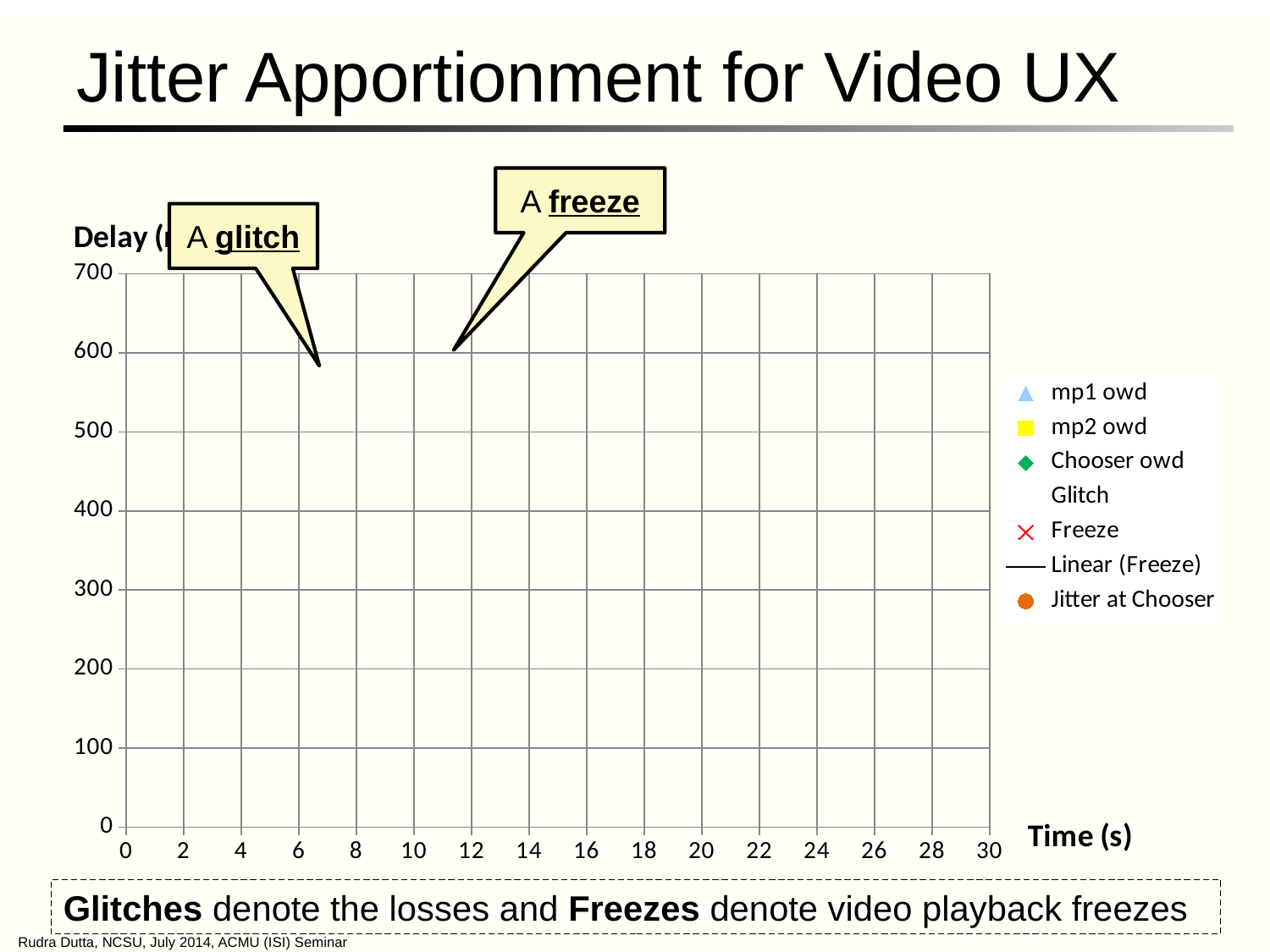
What is the label of the x axis of the chart? Time (s) What is the highest value shown on the chart's y axis? 700 How many series does the chart's legend list? 7 Which legend entry is shown with a red cross marker? Freeze What is the highest value shown on the chart's x axis? 30